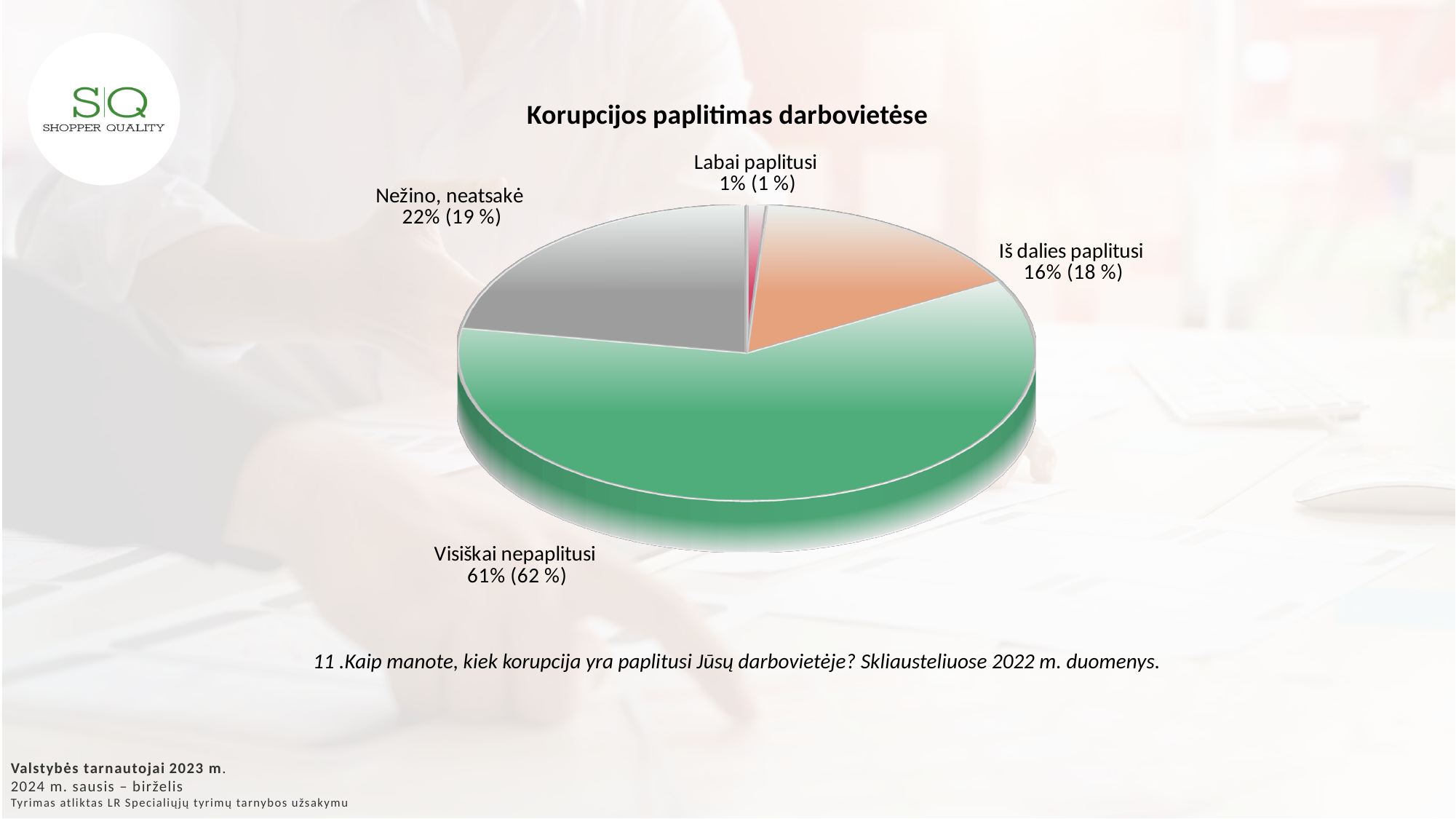
What is the 2023 share for 'Nežino, neatsakė'? 22% What kind of chart is shown on the slide? pie chart What is the 2023 share for 'Labai paplitusi'? 1% What was the 2022 value shown in parentheses for 'Iš dalies paplitusi'? 18 % How many slices does the pie chart have? 4 Which category has the smallest slice? Labai paplitusi What is the difference in percentage points between 'Nežino, neatsakė' and 'Iš dalies paplitusi' in 2023? 6 Which is larger in 2023: 'Nežino, neatsakė' or 'Iš dalies paplitusi'? Nežino, neatsakė Which category has the largest slice? Visiškai nepaplitusi What is the title of the chart? Korupcijos paplitimas darbovietėse What is the 2023 share for 'Visiškai nepaplitusi'? 61% What is the 2023 share for 'Iš dalies paplitusi'? 16%